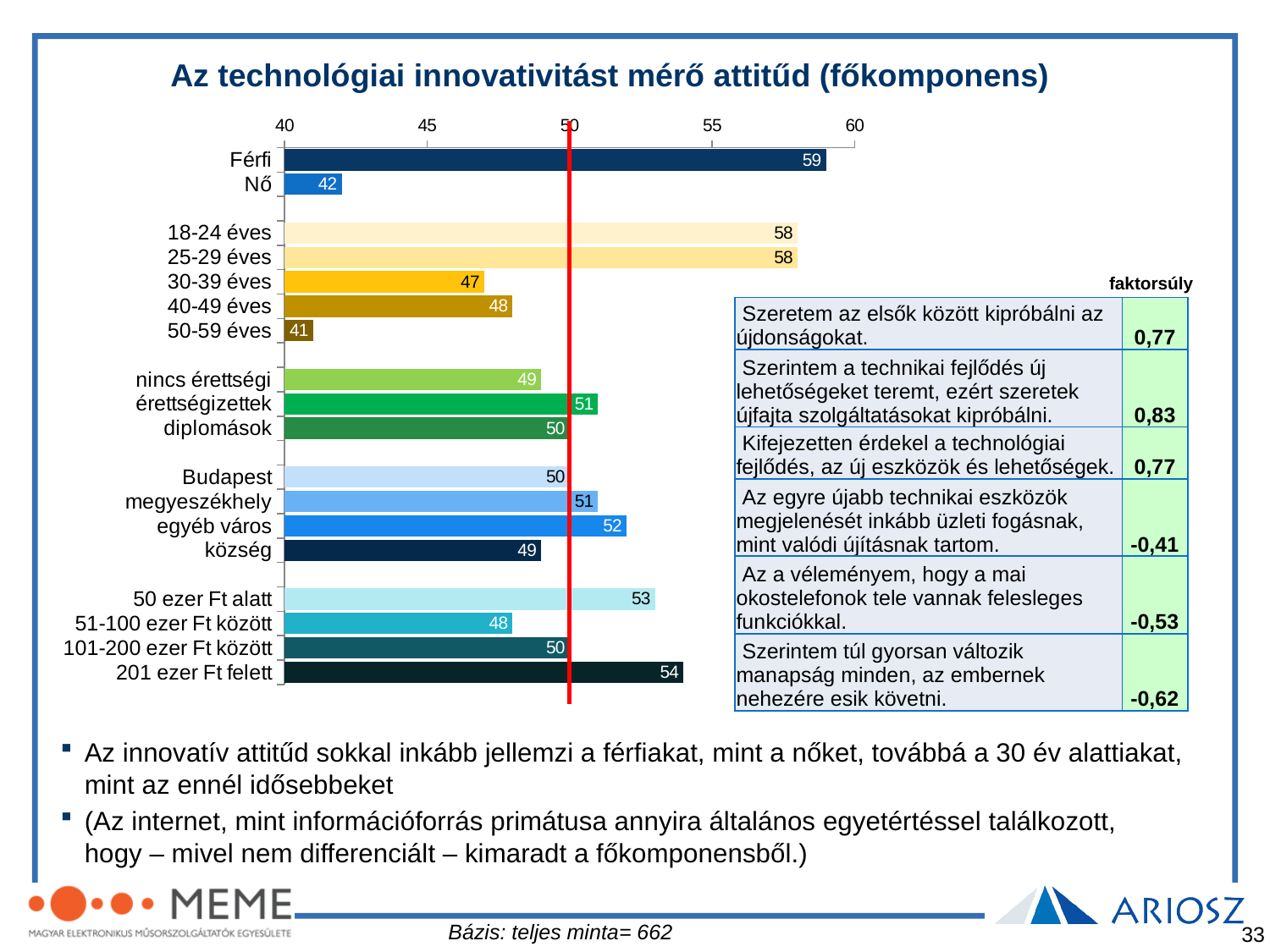
What is the value for Férfi? 59 What is the difference between the values for Férfi and Nő? 17 What is the value for Nő? 42 How many bars are plotted in the chart? 18 Which has a larger value, egyéb város or község? egyéb város Is the value for 18-24 éves greater or less than 55? greater What kind of chart is shown on the slide? bar chart What is the value for 50-59 éves? 41 Which category has the highest value in the chart? Férfi Which category has the lowest value in the chart? 50-59 éves What is the value for 201 ezer Ft felett? 54 What is the title of the slide's chart? Az technológiai innovativitást mérő attitűd (főkomponens)